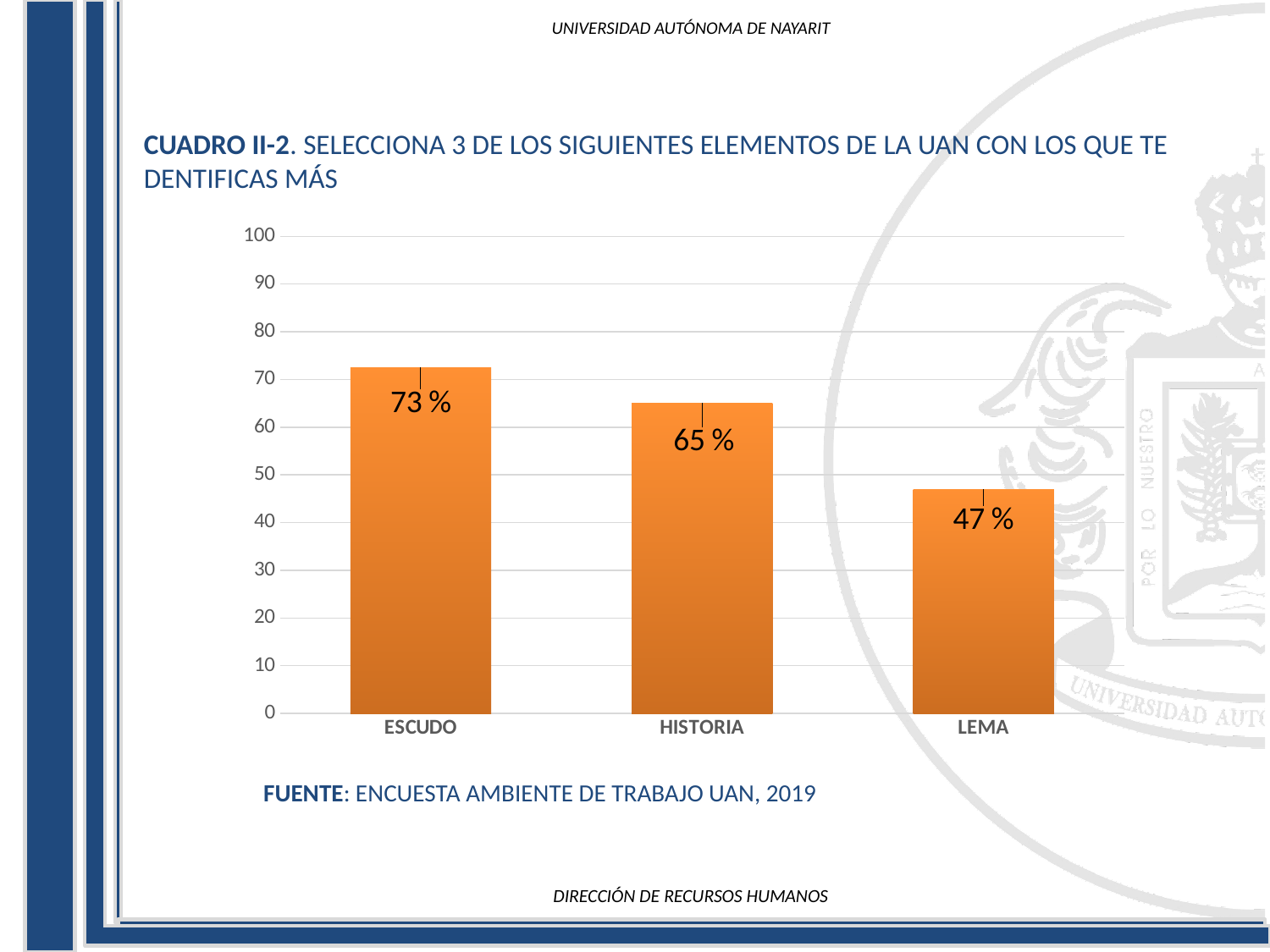
What is the value for HISTORIA? 65 % Is the value for LEMA greater or less than 50? less What is the value for LEMA? 47 % What is the difference between the values for HISTORIA and LEMA? 18 % Which category has the lowest value? LEMA Which is larger, the value for HISTORIA or the value for LEMA? HISTORIA What is the value for ESCUDO? 73 % Do the values rise or fall from ESCUDO to LEMA along the x axis? fall What kind of chart is shown on the slide? bar chart What is the difference between the values for ESCUDO and LEMA? 26 % How many categories are shown in the chart? 3 Which category has the highest value? ESCUDO